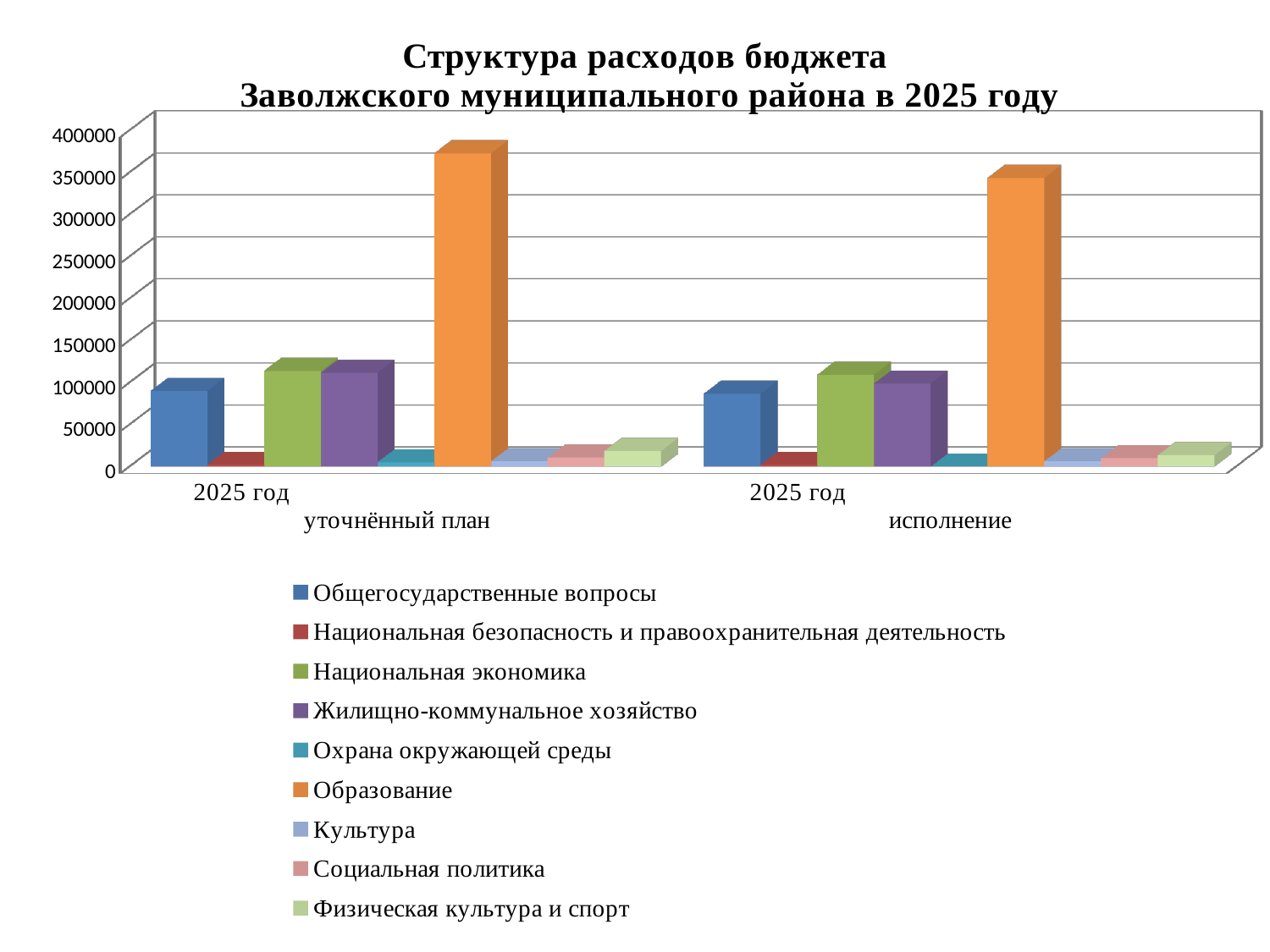
Is the value for Национальная экономика in the "2025 год уточнённый план" group greater or less than 100000? greater What kind of chart is shown on the slide? bar chart Which series has the highest value in the "2025 год исполнение" group? Образование What colour represents the Образование series in the legend? orange Is the value for Общегосударственные вопросы in the "2025 год уточнённый план" group greater or less than 100000? less Is the value for Образование in the "2025 год уточнённый план" group greater or less than 350000? greater Which series has the highest value in the "2025 год уточнённый план" group? Образование How many series does the legend list? 9 How many category groups are plotted along the x axis? 2 Which is larger for Образование: the value in "2025 год уточнённый план" or in "2025 год исполнение"? 2025 год уточнённый план In the "2025 год уточнённый план" group, which is larger: Национальная экономика or Общегосударственные вопросы? Национальная экономика